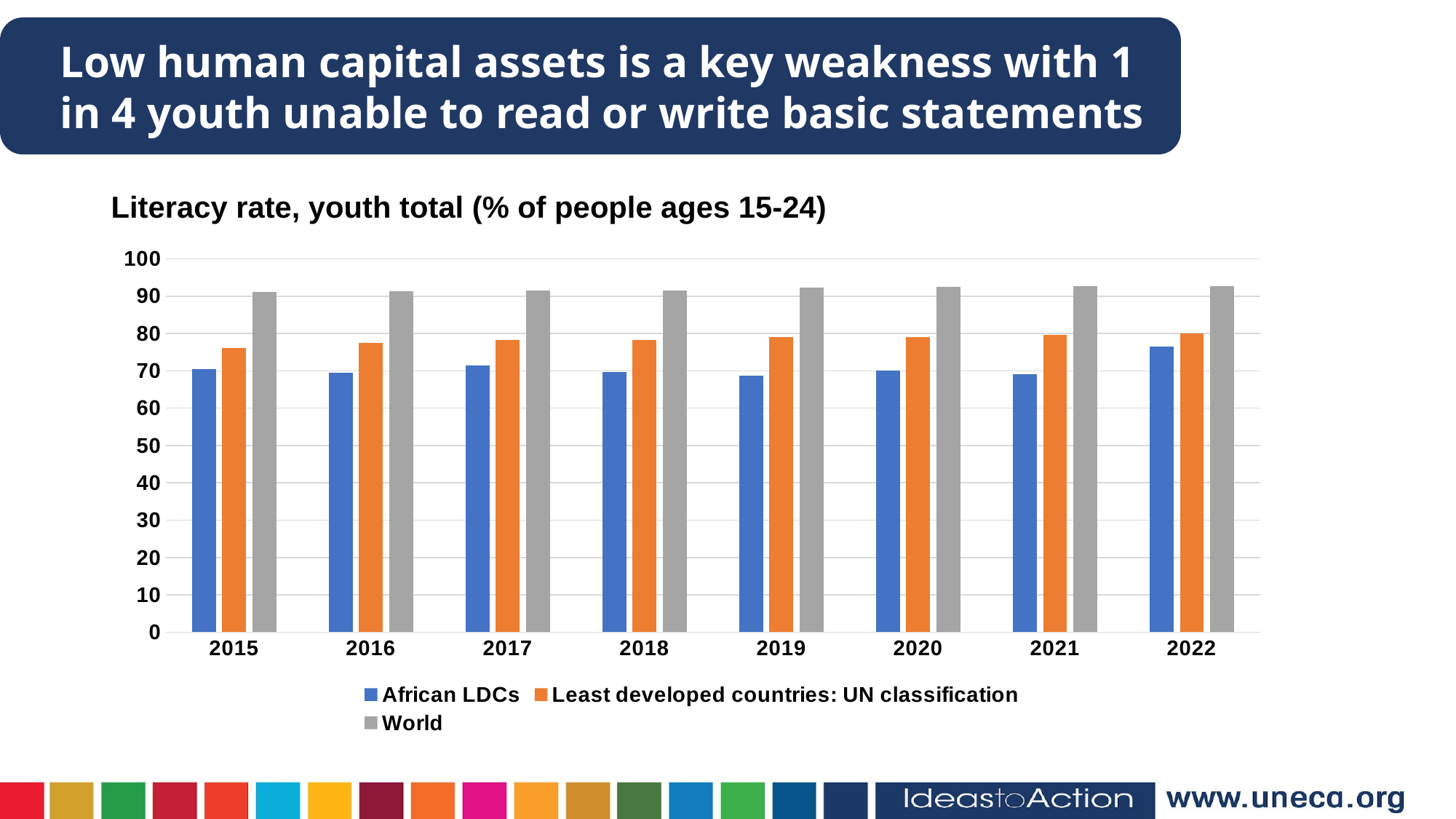
How many years are shown on the x axis? 8 Is the value for African LDCs in 2022 greater or less than 70? greater What kind of chart is shown on the slide? Bar chart Is the value for African LDCs in 2019 greater or less than 70? less Which is larger in 2018: the value for World or the value for African LDCs? World Which series has the highest youth literacy rate in every year shown? World Is the value for Least developed countries: UN classification in 2022 greater or less than 90? less Does the youth literacy rate for Least developed countries: UN classification rise or fall from 2015 to 2022? Rise How many series does the legend list? 3 What is the title of the chart? Literacy rate, youth total (% of people ages 15-24) In which year is the African LDCs youth literacy rate highest? 2022